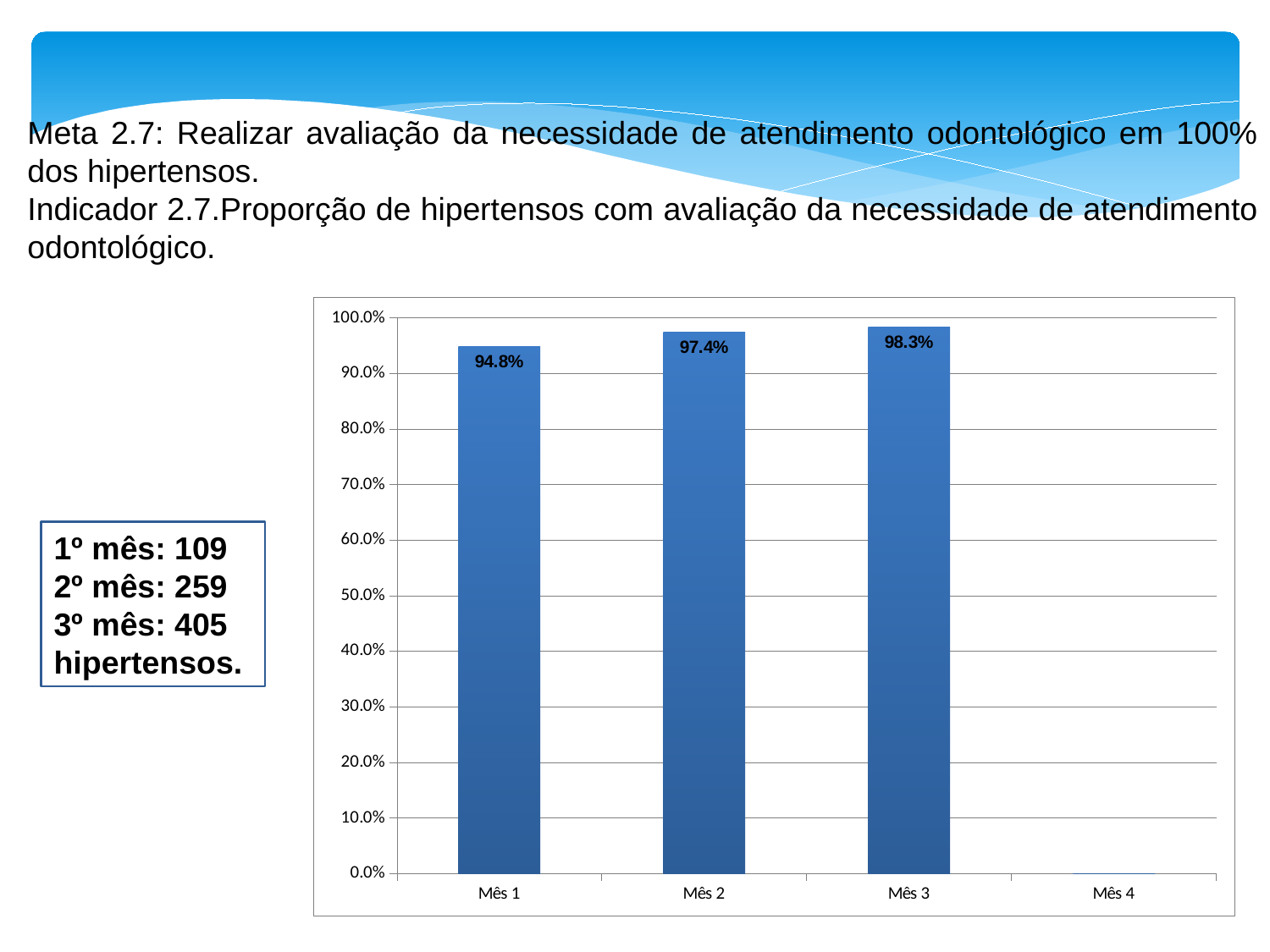
Do the values rise or fall from Mês 1 to Mês 3? rise Which is larger, the value for Mês 2 or the value for Mês 3? Mês 3 Among the three months with bars, which has the lowest value? Mês 1 How many categories are labelled on the x axis? 4 What is the difference between the values for Mês 2 and Mês 1? 2.6 percentage points What type of chart is shown on the slide? bar chart Is the value for Mês 1 greater or less than 90.0%? greater What is the value shown for Mês 3? 98.3% What is the difference between the values for Mês 3 and Mês 1? 3.5 percentage points Which month has the highest value in the chart? Mês 3 What is the value shown for Mês 2? 97.4% What is the value shown for Mês 1? 94.8%